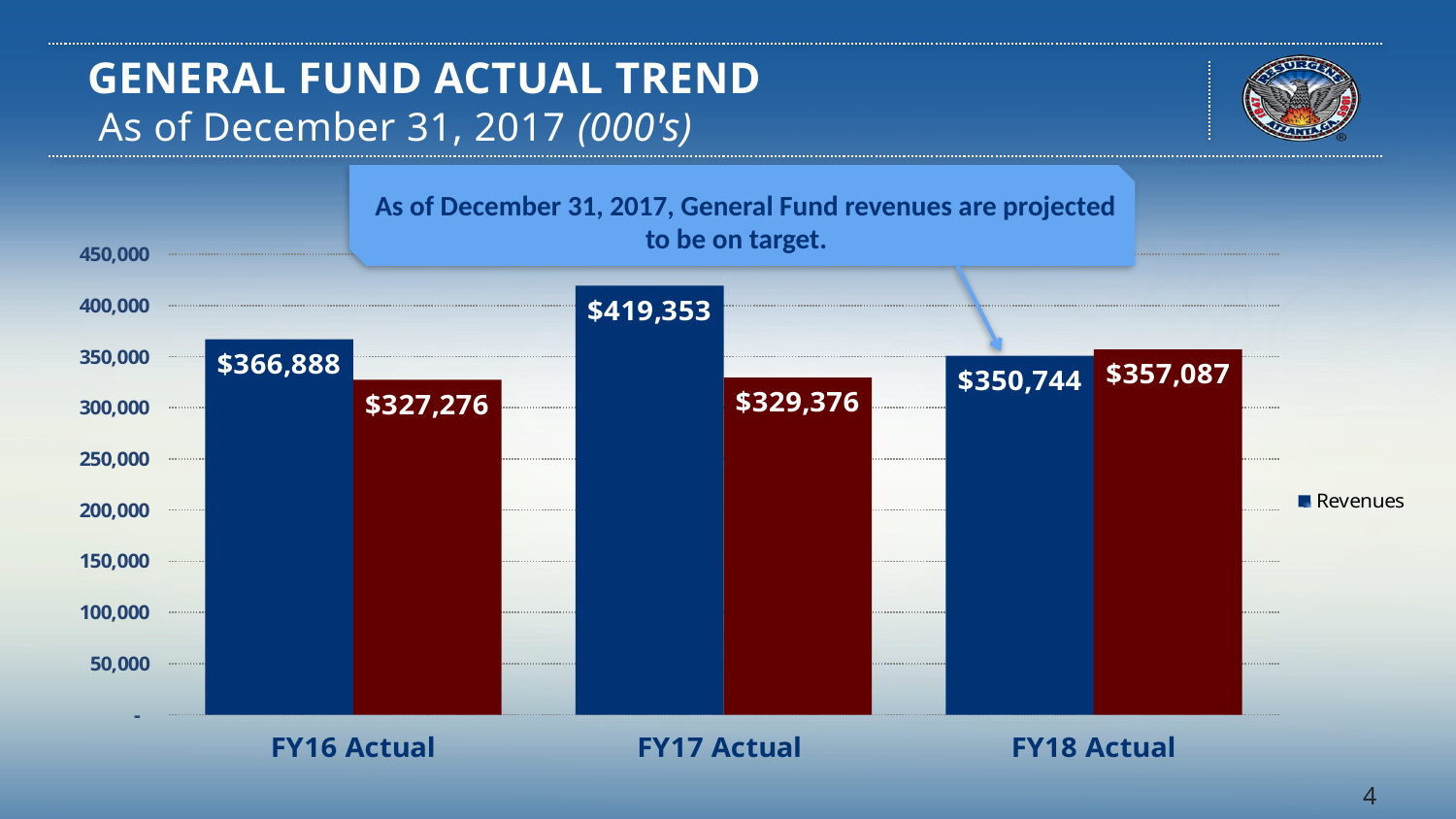
For FY18 Actual, which is larger: the blue Revenues bar or the dark red bar? The dark red bar How do the Revenues values change from FY16 Actual to FY18 Actual? They rise then fall What value is shown on the dark red bar for FY18 Actual? $357,087 What is the Revenues value for FY17 Actual? $419,353 Which fiscal year has the lowest Revenues value? FY18 Actual Which fiscal year has the highest Revenues value? FY17 Actual How many fiscal year categories are shown on the x axis? 3 Is the Revenues value for FY16 Actual greater or less than 350,000? greater What is the Revenues value for FY16 Actual? $366,888 How many series does the legend list? 1 What is the difference between the Revenues values for FY17 Actual and FY16 Actual? $52,465 What kind of chart is shown on the slide? Bar chart